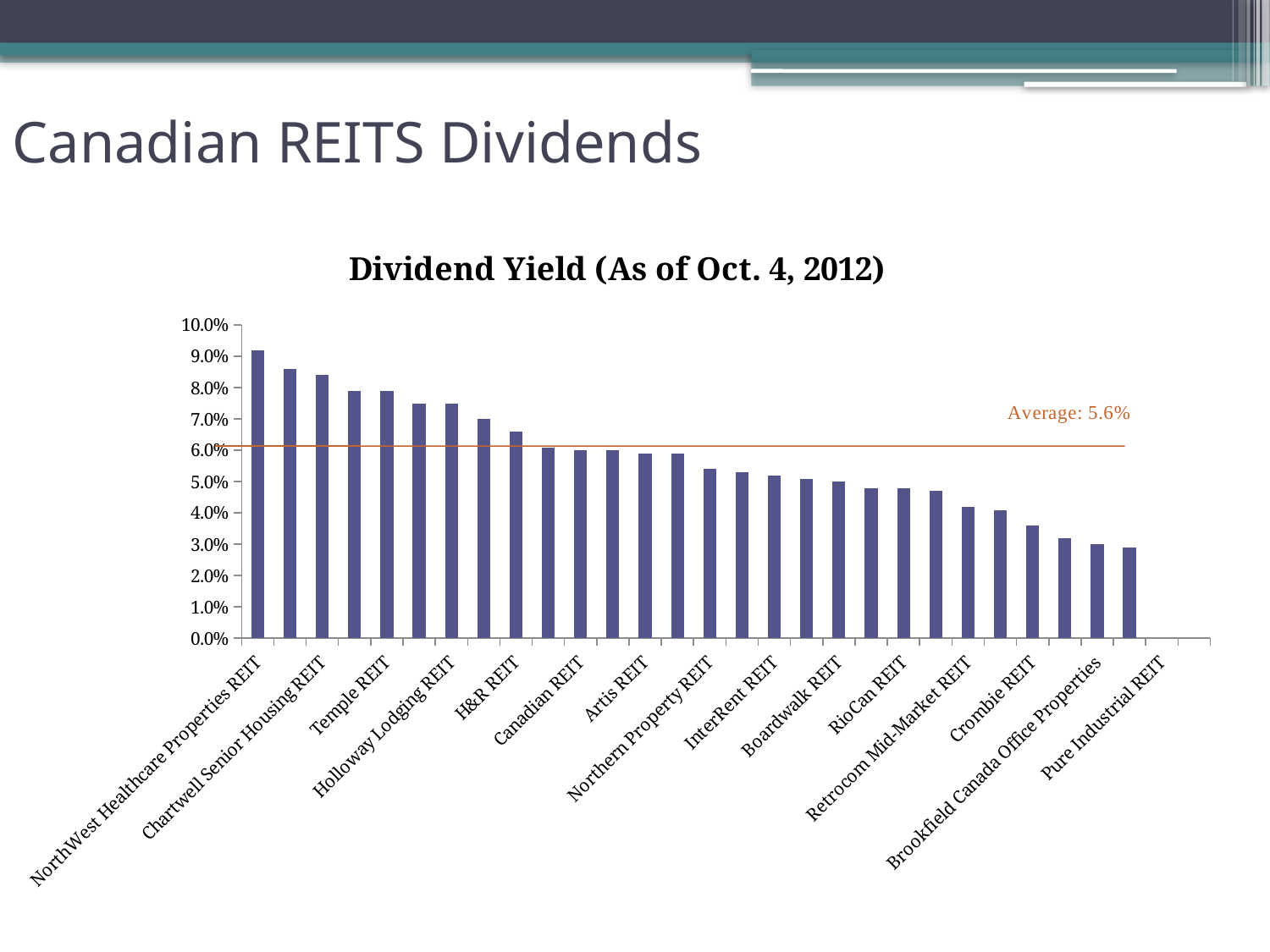
What is the title of the chart? Dividend Yield (As of Oct. 4, 2012) Is the dividend yield for Pure Industrial REIT greater or less than 4.0%? less Do the dividend yields rise or fall moving from left to right along the x axis? Fall Is the dividend yield for NorthWest Healthcare Properties REIT greater or less than 8.0%? greater Which has the larger dividend yield, NorthWest Healthcare Properties REIT or Pure Industrial REIT? NorthWest Healthcare Properties REIT Is the highest bar in the chart greater or less than 10.0%? less Which REIT has the highest dividend yield in the chart? NorthWest Healthcare Properties REIT What average dividend yield is annotated on the chart? 5.6% Which REIT has the lowest dividend yield in the chart? Pure Industrial REIT What kind of chart is shown on the slide? Bar chart